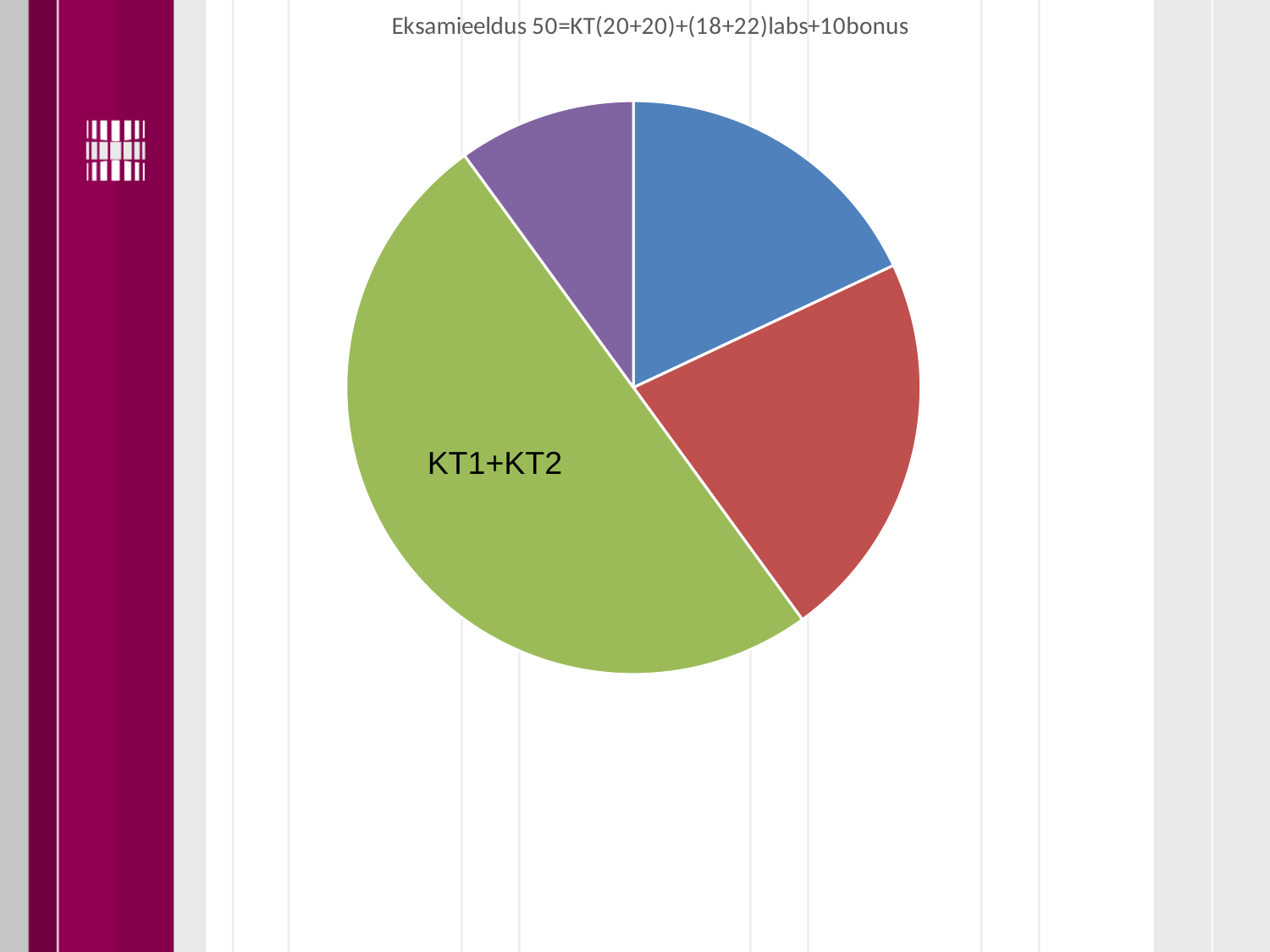
What colour is the smallest slice of the pie chart? purple Which slice is larger, the red slice or the blue slice? the red slice What kind of chart is shown on the slide? pie chart Which slice of the pie chart is the largest? KT1+KT2 Which slice of the pie chart carries a text label, and what does it say? the green slice, KT1+KT2 Which slice is larger, the blue slice or the purple slice? the blue slice What colour is the largest slice of the pie chart? green How many slices does the pie chart have? 4 Which slice is larger, the KT1+KT2 slice or the purple slice? KT1+KT2 What is the title of the pie chart? Eksamieeldus 50=KT(20+20)+(18+22)labs+10bonus